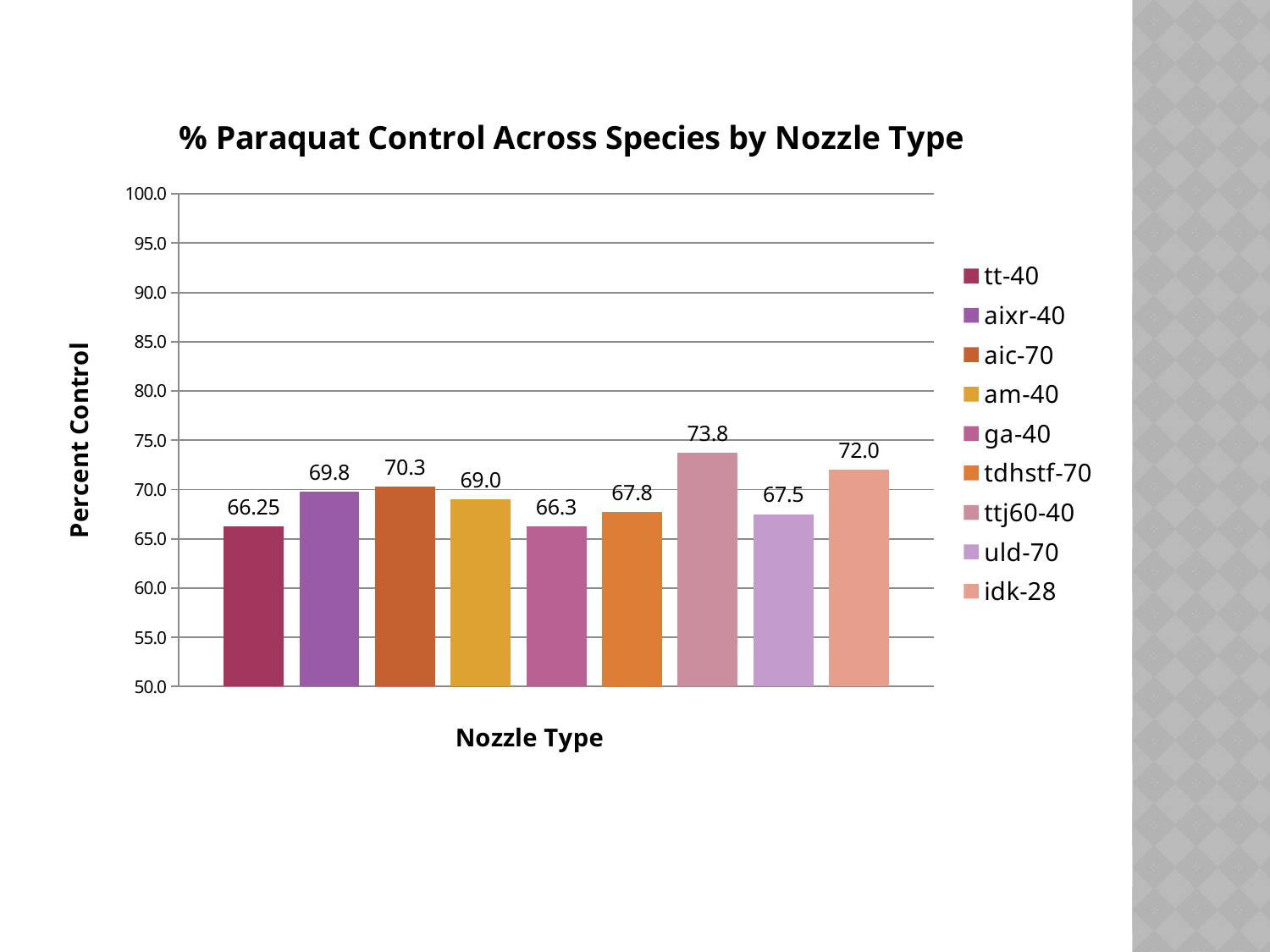
What is the percent control for the idk-28 nozzle? 72.0 What kind of chart is shown on the slide? bar chart What is the difference in percent control between aic-70 and am-40? 1.3 Which nozzle type has the highest percent control? ttj60-40 How many nozzle types are shown in the chart? 9 What is the title of the chart? % Paraquat Control Across Species by Nozzle Type What is the difference in percent control between ttj60-40 and tt-40? 7.55 What is the percent control for the ttj60-40 nozzle? 73.8 Which has a higher percent control, aixr-40 or uld-70? aixr-40 What is the percent control for the tt-40 nozzle? 66.25 Which nozzle type has the lowest percent control? tt-40 Is the value for tdhstf-70 greater or less than 70.0? less